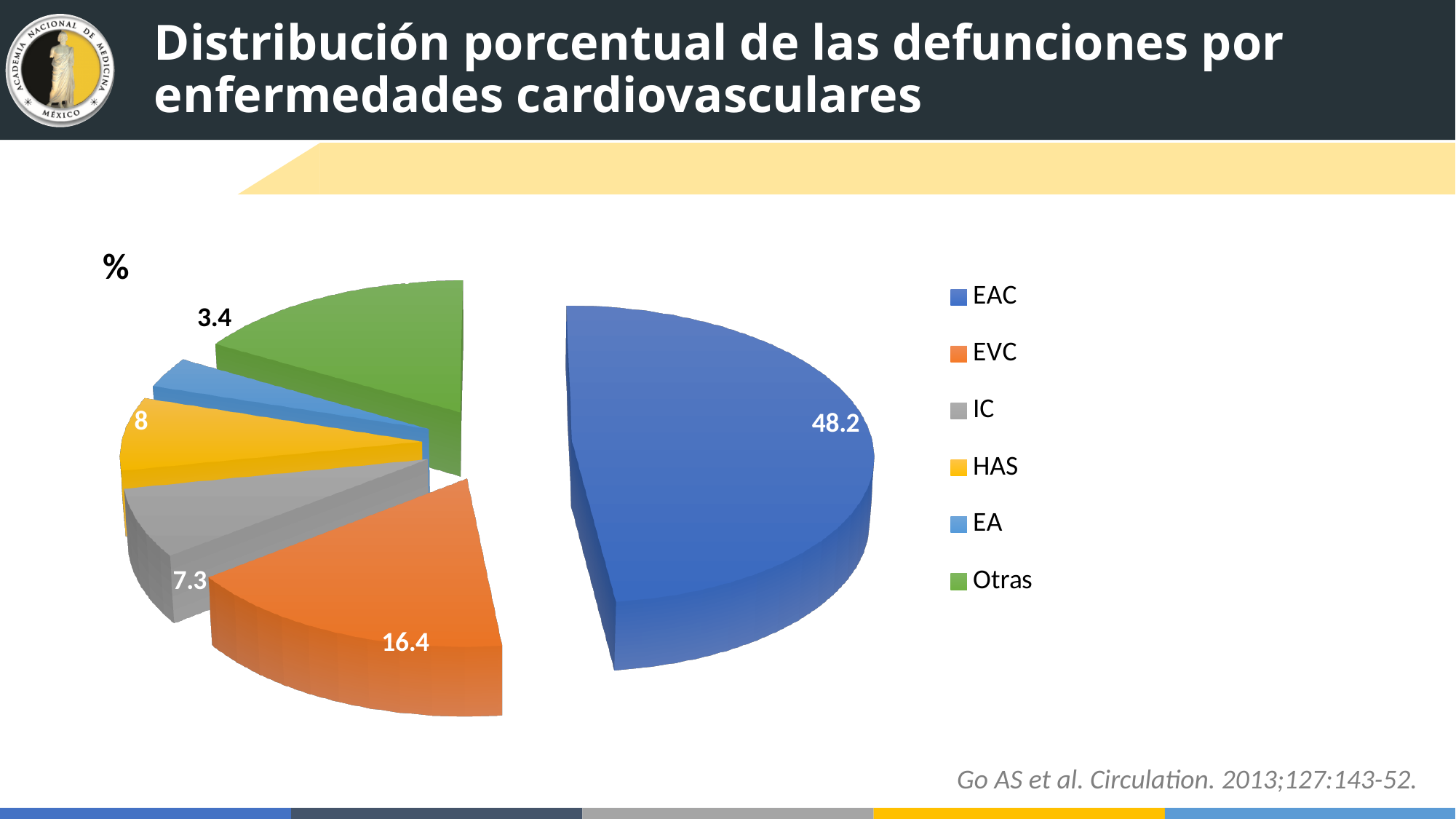
What is the value shown for EA in the pie chart? 3.4 What is the value shown for EAC in the pie chart? 48.2 How many categories does the pie chart show? 6 What colour is the EAC slice in the pie chart? Blue Which is larger, the value for HAS or the value for IC? HAS What kind of chart is shown on the slide? Pie chart What is the value shown for HAS in the pie chart? 8 What is the value shown for IC in the pie chart? 7.3 Which category has the smallest slice of the pie chart? EA What is the difference between the values for EAC and EVC? 31.8 What is the value shown for EVC in the pie chart? 16.4 Which category has the largest slice of the pie chart? EAC